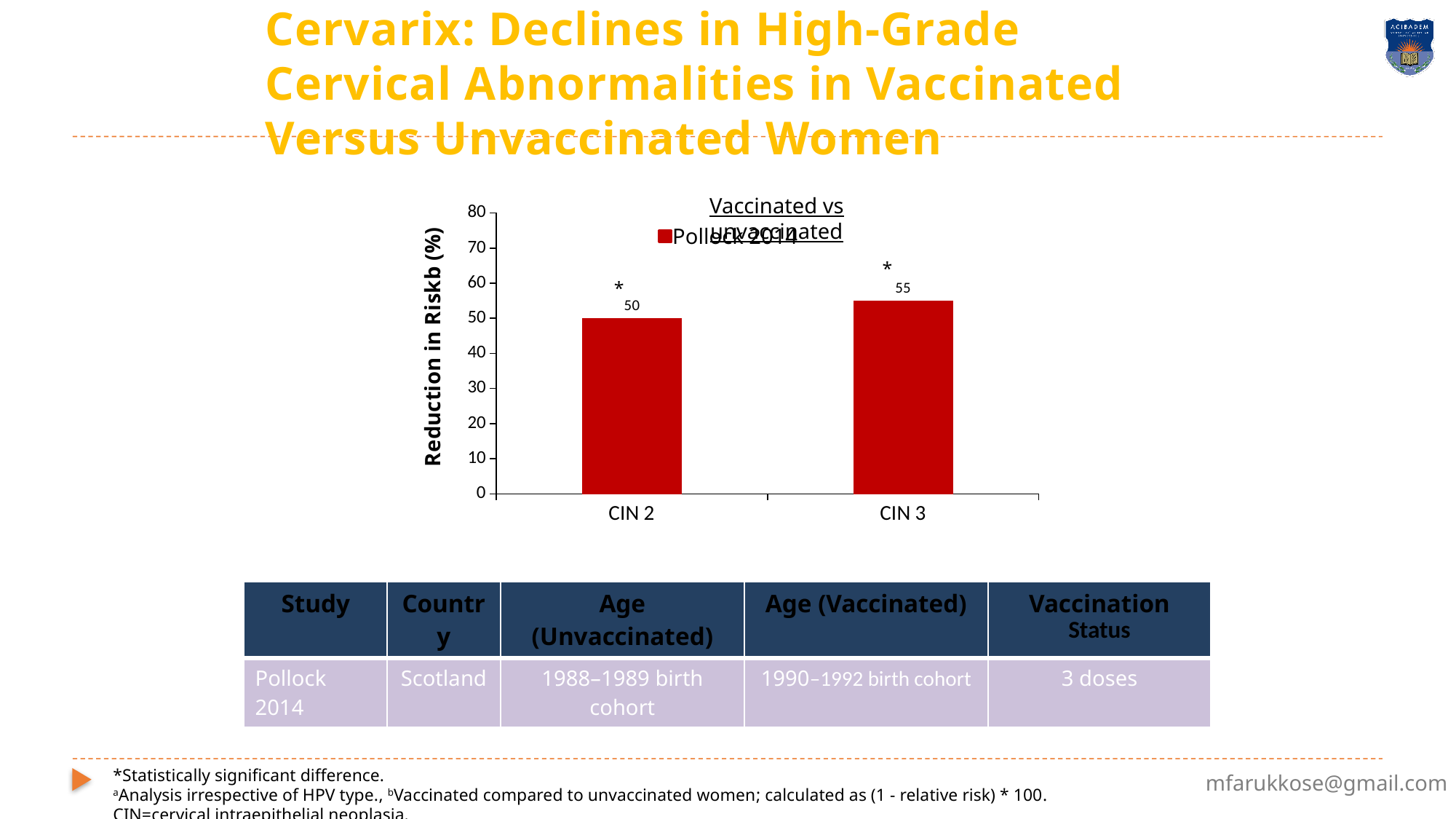
Is the value for CIN 3 greater or less than 60? less What is the reduction in risk value for CIN 2? 50 How many categories are shown on the x axis of the chart? 2 What kind of chart is shown on the slide? Bar chart How many series does the chart legend list? 1 Is the value for CIN 2 greater or less than 40? greater Which category has the higher reduction in risk, CIN 2 or CIN 3? CIN 3 Which category has the lower reduction in risk? CIN 2 What series name is shown in the chart legend? Pollock 2014 What is the reduction in risk value for CIN 3? 55 What is the label of the y axis of the chart? Reduction in Riskb (%) What is the difference between the CIN 3 and CIN 2 values? 5